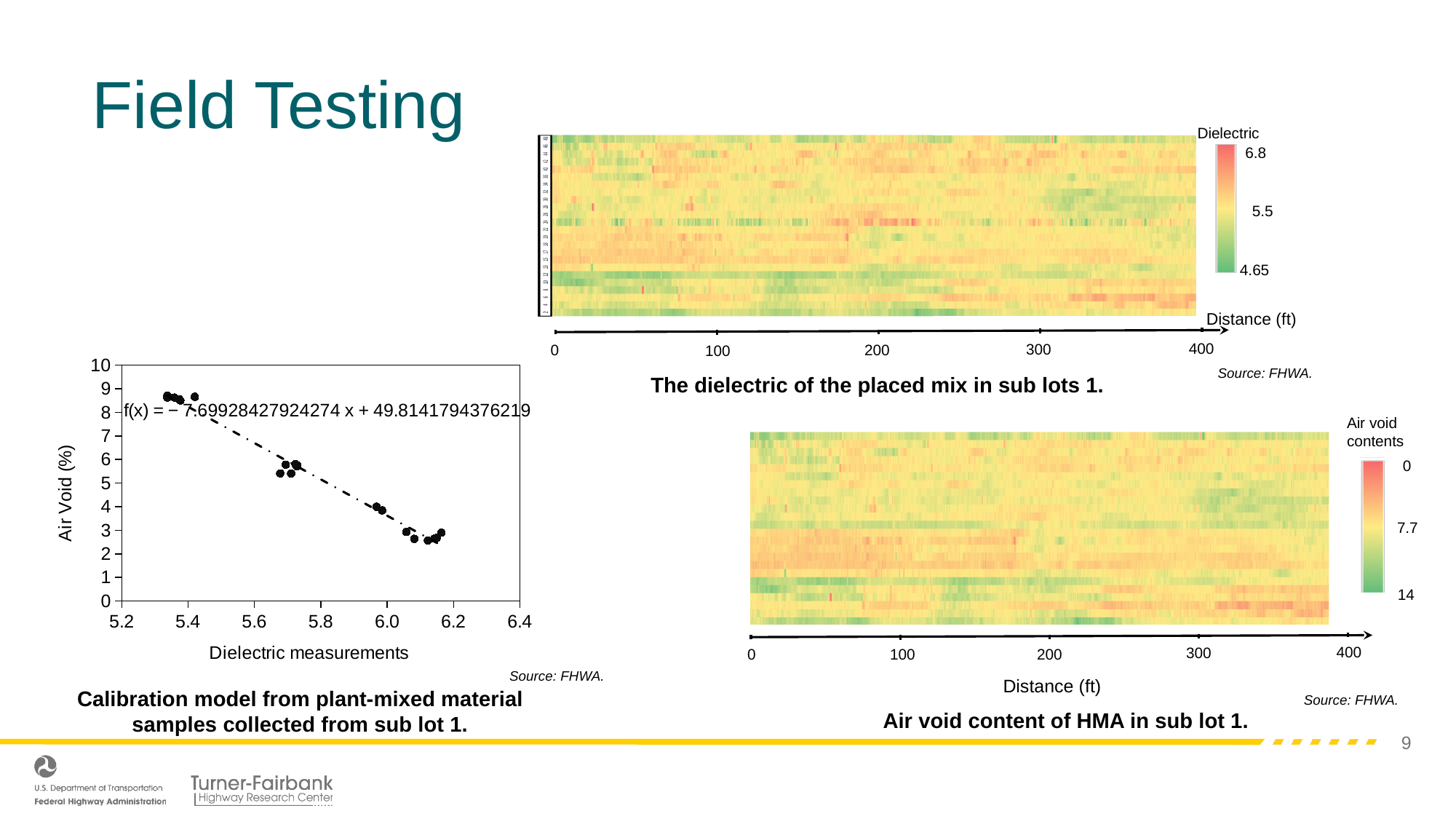
In the calibration model chart, is the air void value for the points at a dielectric measurement of about 6.1 greater or less than 4? less In the calibration model chart, is the air void value for the point at a dielectric measurement of about 6.0 greater or less than 5? less In the calibration model chart, which group of points has higher air void: those near a dielectric of 5.4 or those near 5.7? those near 5.4 In the calibration model chart, what is the intercept of the fitted line f(x) shown on the chart? 49.8141794376219 In the calibration model chart, what is the slope of the fitted line f(x) shown on the chart? −7.69928427924274 In the calibration model chart, is the air void value for the points at a dielectric measurement of about 5.4 greater or less than 8? greater What kind of chart is the 'Calibration model from plant-mixed material samples collected from sub lot 1' chart? scatter chart In the calibration model chart, what is the highest value shown on the y axis? 10 In the calibration model chart, what is the label of the x axis? Dielectric measurements In the calibration model chart, does Air Void (%) rise or fall as the dielectric measurement increases? fall In the calibration model chart, what is the highest value shown on the x axis? 6.4 In the calibration model chart, what is the label of the y axis? Air Void (%)